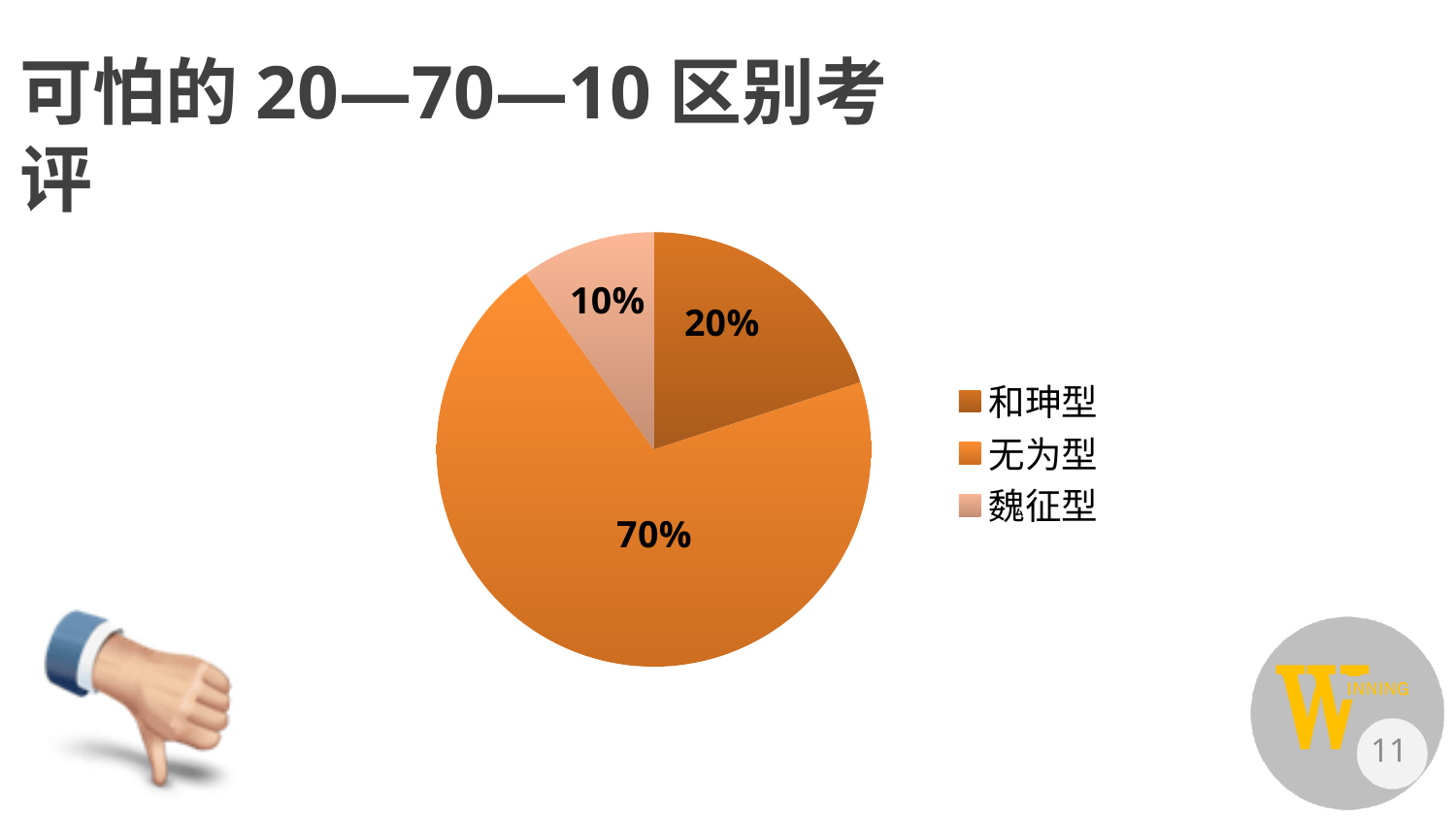
What is the difference between the values for 无为型 and 和珅型? 50% What is the value for 魏征型? 10% What kind of chart is shown on the slide? pie chart What is the value for 和珅型? 20% What is the difference between the values for 和珅型 and 魏征型? 10% How many entries does the legend list? 3 Which is larger, the value for 和珅型 or the value for 魏征型? 和珅型 Which category has the smallest slice? 魏征型 How many slices does the pie chart have? 3 What share of the pie does 无为型 take? 70% Which category has the largest slice? 无为型 What is the value for 无为型? 70%